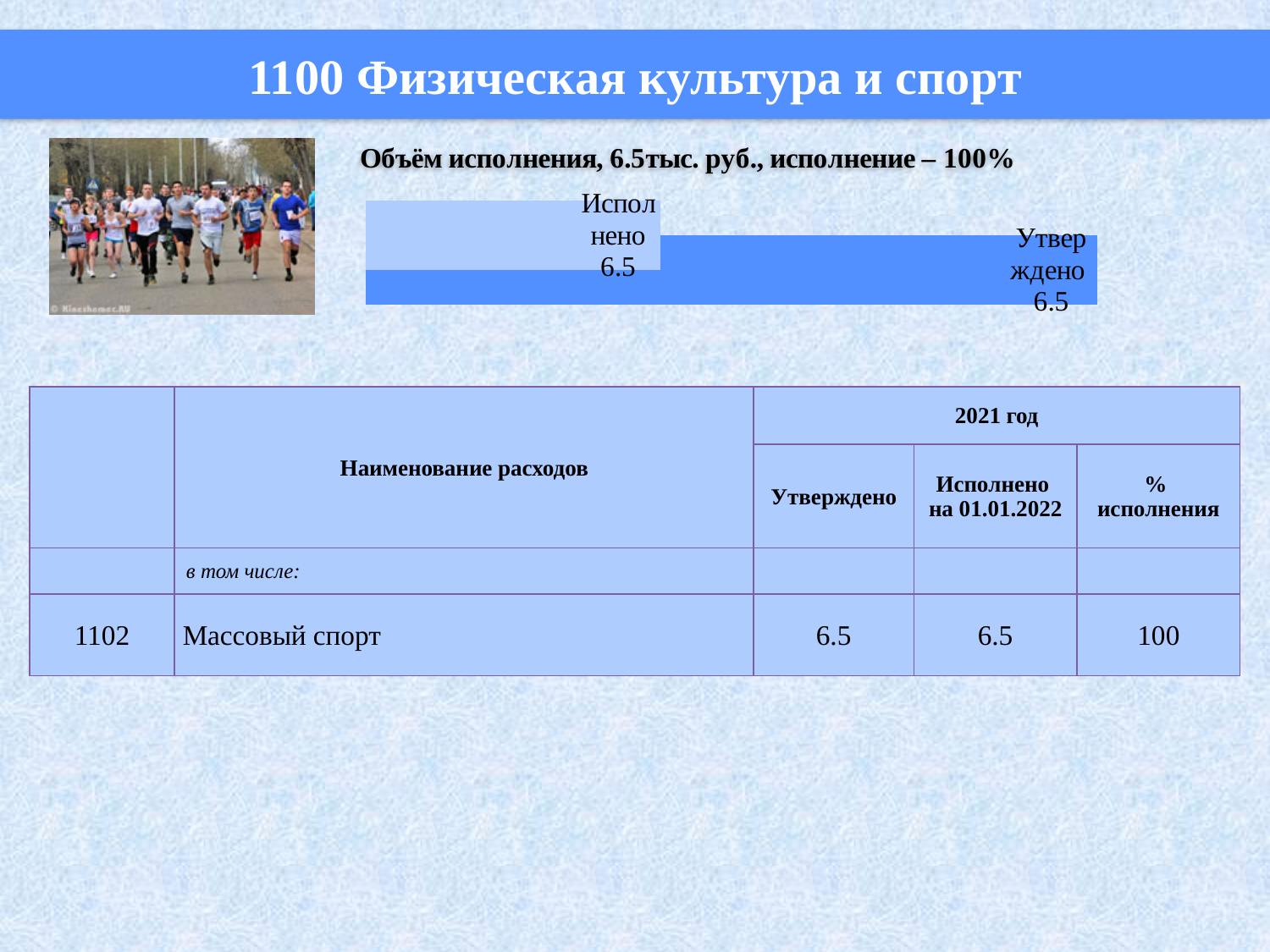
How many bars are plotted in the chart? 2 Are the bars in the chart oriented horizontally or vertically? horizontally What is the total of the two values labelled in the chart? 13 What value is shown for Утверждено in the chart? 6.5 What is the difference between the Утверждено and Исполнено values in the chart? 0 What kind of chart is shown on the slide? bar chart What execution percentage is stated in the text above the chart? 100% What value is shown for Исполнено in the chart? 6.5 Which bar in the chart is drawn in the lighter blue colour? Исполнено